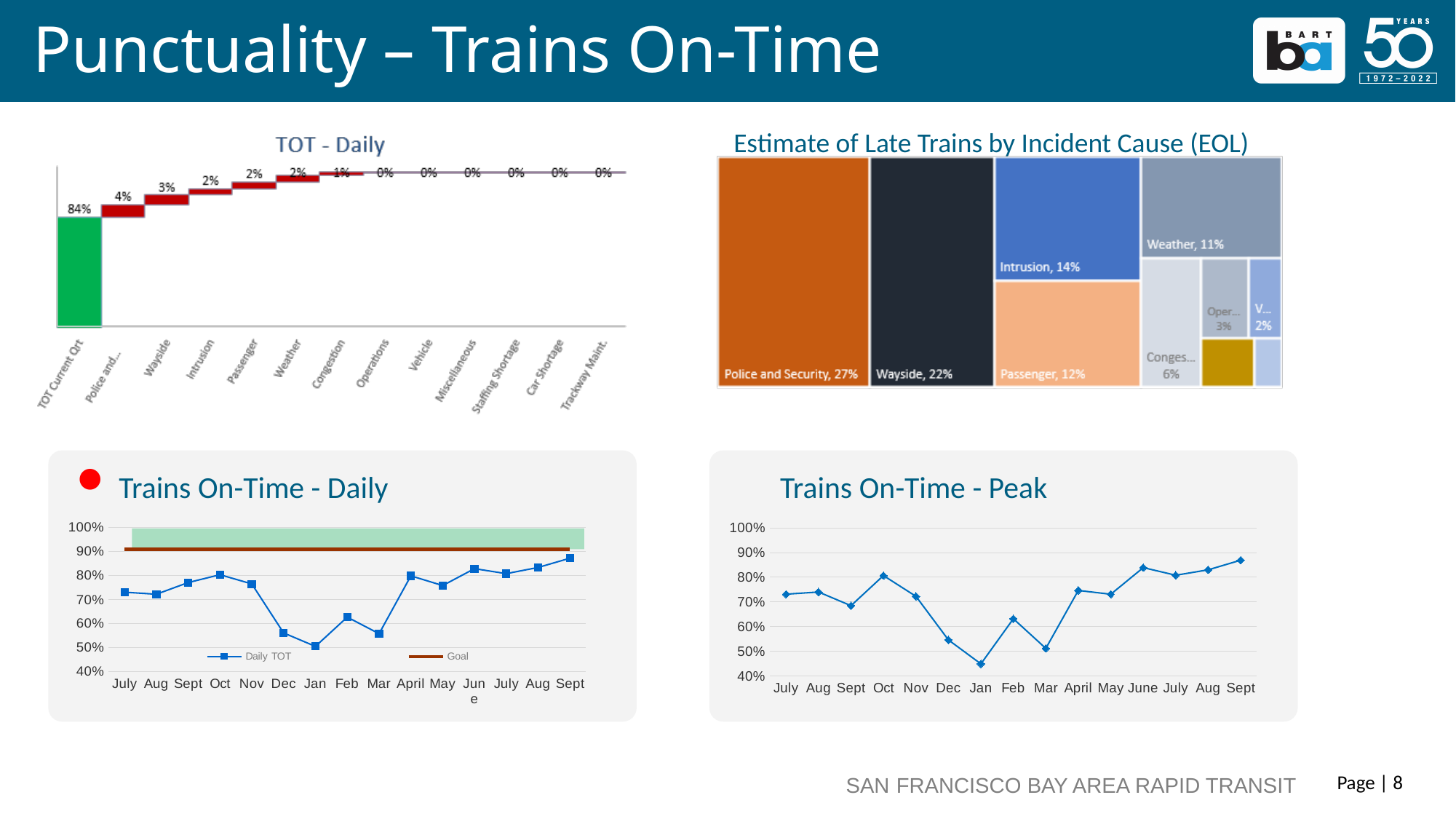
In the Estimate of Late Trains by Incident Cause (EOL) chart, what is the difference between the Wayside and Weather shares? 11% In the Trains On-Time - Daily chart, which month has the lowest Daily TOT value? Jan In the TOT - Daily chart, what is the value for Wayside? 3% In the TOT - Daily chart, how many categories are shown on the x axis? 13 In the Estimate of Late Trains by Incident Cause (EOL) chart, which incident cause has the largest share? Police and Security In the Trains On-Time - Daily chart, is the Daily TOT value for Dec greater or less than 60%? less In the Estimate of Late Trains by Incident Cause (EOL) chart, what share is attributed to Police and Security? 27% In the Trains On-Time - Peak chart, is the value for Jan greater or less than 50%? less In the Estimate of Late Trains by Incident Cause (EOL) chart, what share is attributed to Intrusion? 14% What kind of chart is the Trains On-Time - Peak chart? line chart In the Trains On-Time - Daily chart, how many series does the legend list? 2 In the TOT - Daily chart, what is the value for TOT Current Qrt? 84%